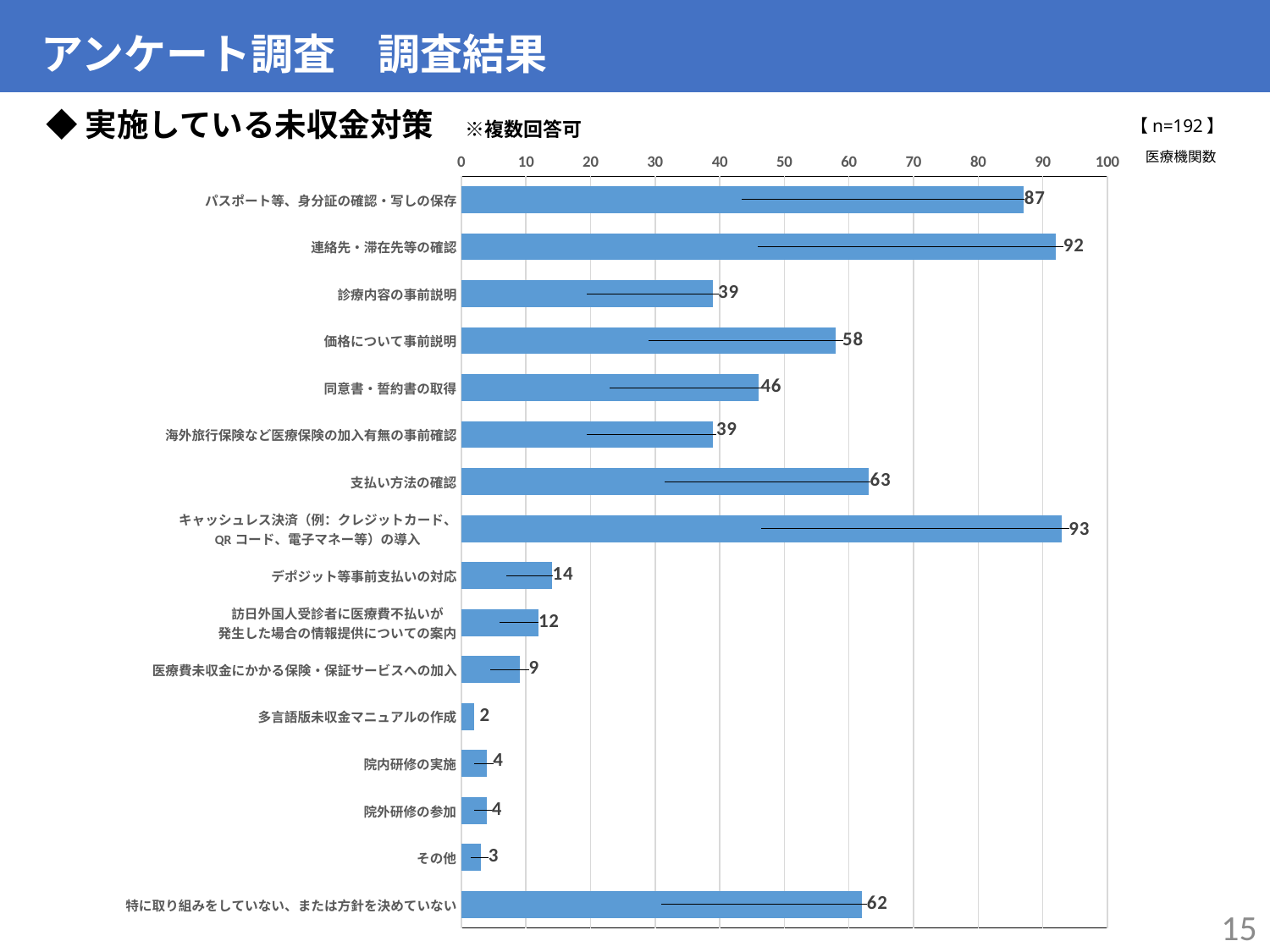
Which is larger, the value for 価格について事前説明 or the value for 同意書・誓約書の取得? 価格について事前説明 What kind of chart is shown on the slide? bar chart What is the difference between the values for 連絡先・滞在先等の確認 and パスポート等、身分証の確認・写しの保存? 5 Is the value for 支払い方法の確認 greater or less than 60? greater How many categories are shown in the chart? 16 Which category has the highest value? キャッシュレス決済（例：クレジットカード、QRコード、電子マネー等）の導入 Which category has the lowest value? 多言語版未収金マニュアルの作成 What is the value for 同意書・誓約書の取得? 46 What is the value for 連絡先・滞在先等の確認? 92 What is the value for 特に取り組みをしていない、または方針を決めていない? 62 What is the value for デポジット等事前支払いの対応? 14 What is the sample size (n) shown for the chart? n=192